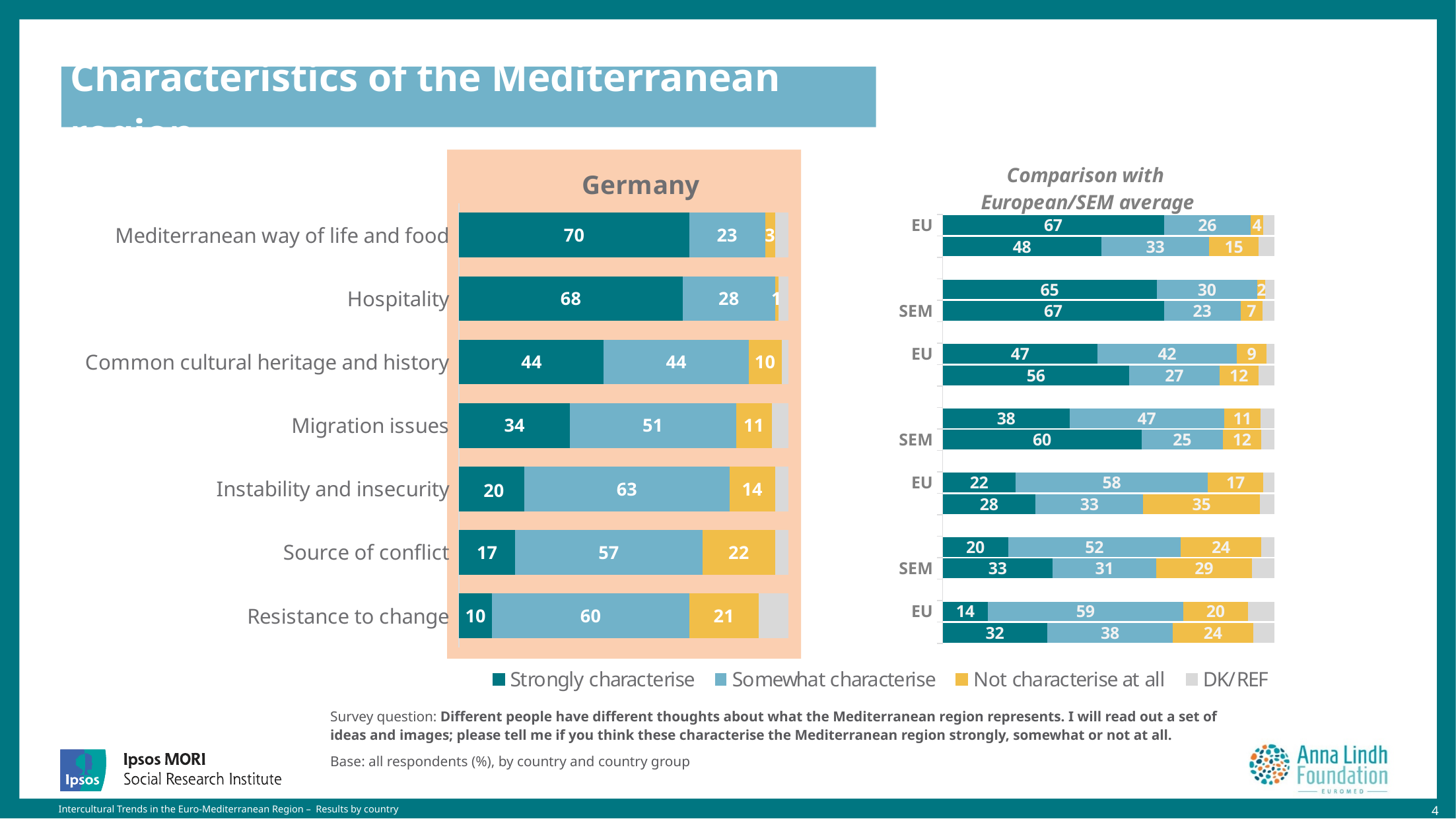
In the 'Comparison with European/SEM average' chart, what is the SEM 'Not characterise at all' value in the fifth pair of bars (Instability and insecurity)? 35 In the Germany chart, which category has the lowest 'Strongly characterise' value? Resistance to change How many series does the legend list? 4 In the Germany chart, what is the 'Somewhat characterise' value for 'Instability and insecurity'? 63 In the Germany chart, what is the difference between the 'Strongly characterise' values for 'Hospitality' and 'Common cultural heritage and history'? 24 In the Germany chart, which is larger: the 'Not characterise at all' value for 'Source of conflict' or for 'Resistance to change'? Source of conflict In the 'Comparison with European/SEM average' chart, what is the EU 'Strongly characterise' value in the top pair of bars (Mediterranean way of life and food)? 67 In the Germany chart, what percentage say 'Mediterranean way of life and food' strongly characterises the region? 70 In the Germany chart, what is the total of the three labelled segments for 'Migration issues'? 96 In the Germany chart, which category has the highest 'Strongly characterise' value? Mediterranean way of life and food What kind of chart is the Germany chart? Stacked bar chart How many categories are shown in the Germany chart? 7